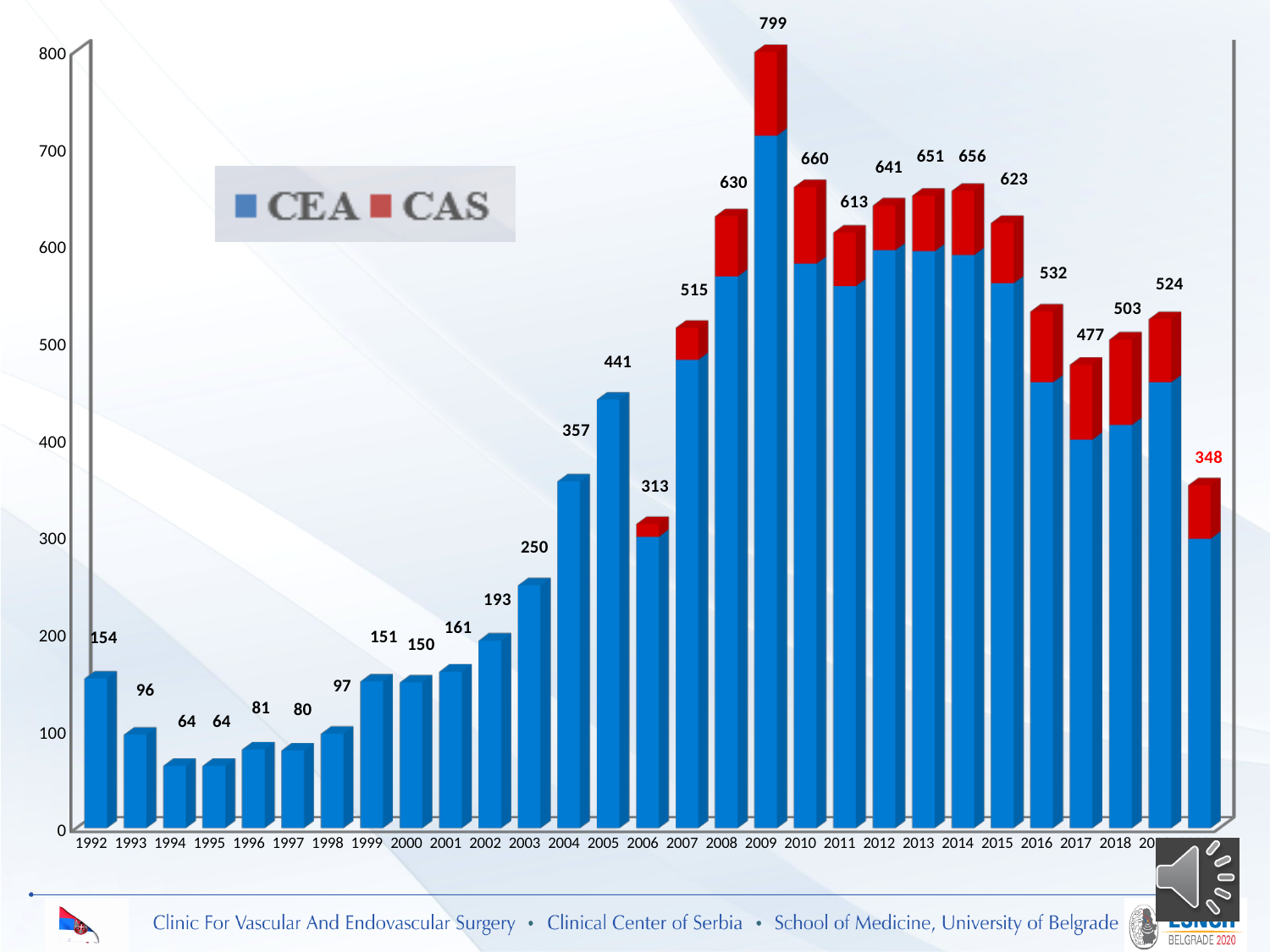
Do the totals rise or fall from 1992 to 1995? fall How many series does the legend list? 2 What is the difference between the totals for 2014 and 2013? 5 What is the total value labeled for 2009? 799 What colour represents CAS in the legend? red What is the total value labeled for 2005? 441 What kind of chart is shown on the slide? bar chart Do the totals rise or fall from 2003 to 2005? rise Which year has the larger total, 2010 or 2011? 2010 What is the difference between the totals for 2008 and 2007? 115 Which year has the highest total? 2009 Is the CEA value for 2016 greater or less than 500? less